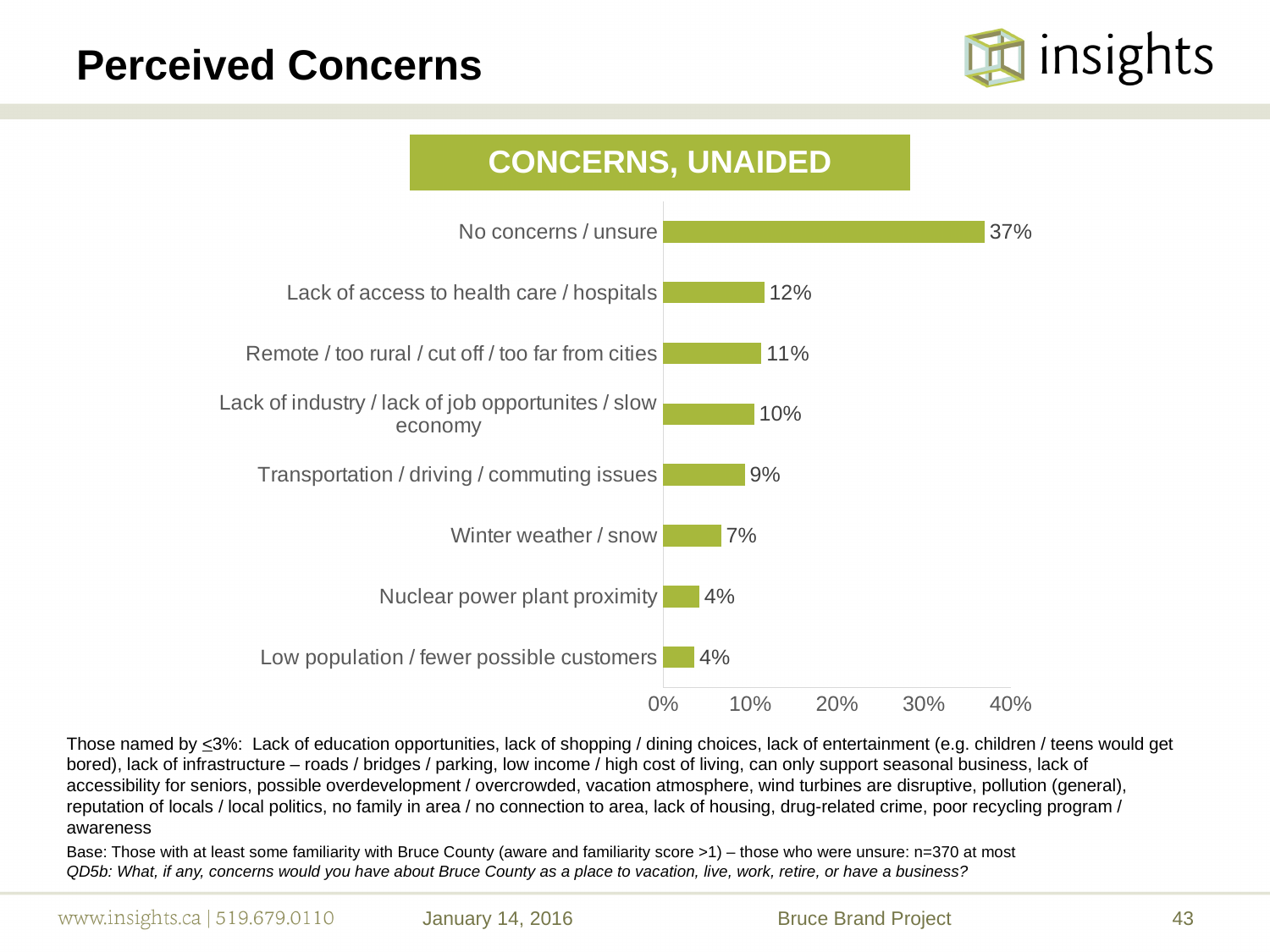
What kind of chart is shown on the slide? Bar chart What percentage is shown for "Winter weather / snow"? 7% Is the value for "No concerns / unsure" greater or less than 30%? greater Which category has the highest value? No concerns / unsure What percentage is shown for "No concerns / unsure"? 37% How many categories are shown in the chart? 8 Which is larger: "Lack of industry / lack of job opportunites / slow economy" or "Nuclear power plant proximity"? Lack of industry / lack of job opportunites / slow economy What is the difference between "No concerns / unsure" and "Lack of access to health care / hospitals"? 25% What is the value for "Lack of access to health care / hospitals"? 12% What is the title of the chart? CONCERNS, UNAIDED What is the value for "Transportation / driving / commuting issues"? 9% What is the difference between "Remote / too rural / cut off / too far from cities" and "Winter weather / snow"? 4%